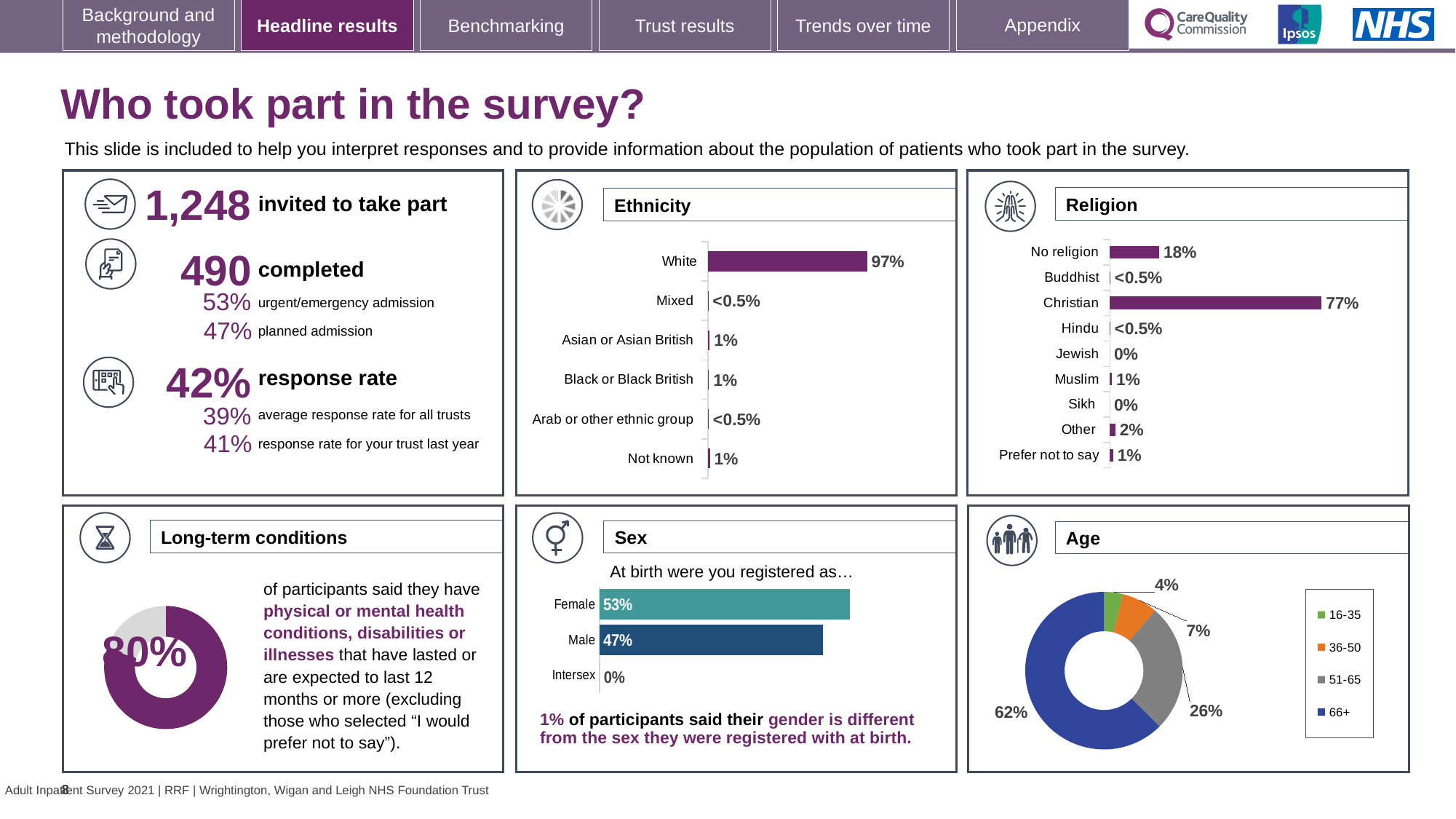
In the Sex chart, what is the difference between the Female and Male values? 6 percentage points In the Age chart, which age group has the smallest share? 16-35 In the Religion chart, which religion category has the highest value? Christian How many ethnicity categories are shown in the Ethnicity chart? 6 In the Age chart, what share of participants were aged 66+? 62% How many age groups does the legend of the Age chart list? 4 In the Ethnicity chart, what percentage of participants were White? 97% What type of chart is the Sex chart? Bar chart In the Sex chart, what percentage of participants were registered as Male at birth? 47% In the Religion chart, what percentage of participants said they had no religion? 18% In the Religion chart, what is the difference between the Christian value and the No religion value? 59 percentage points How many categories are listed in the Religion chart? 9